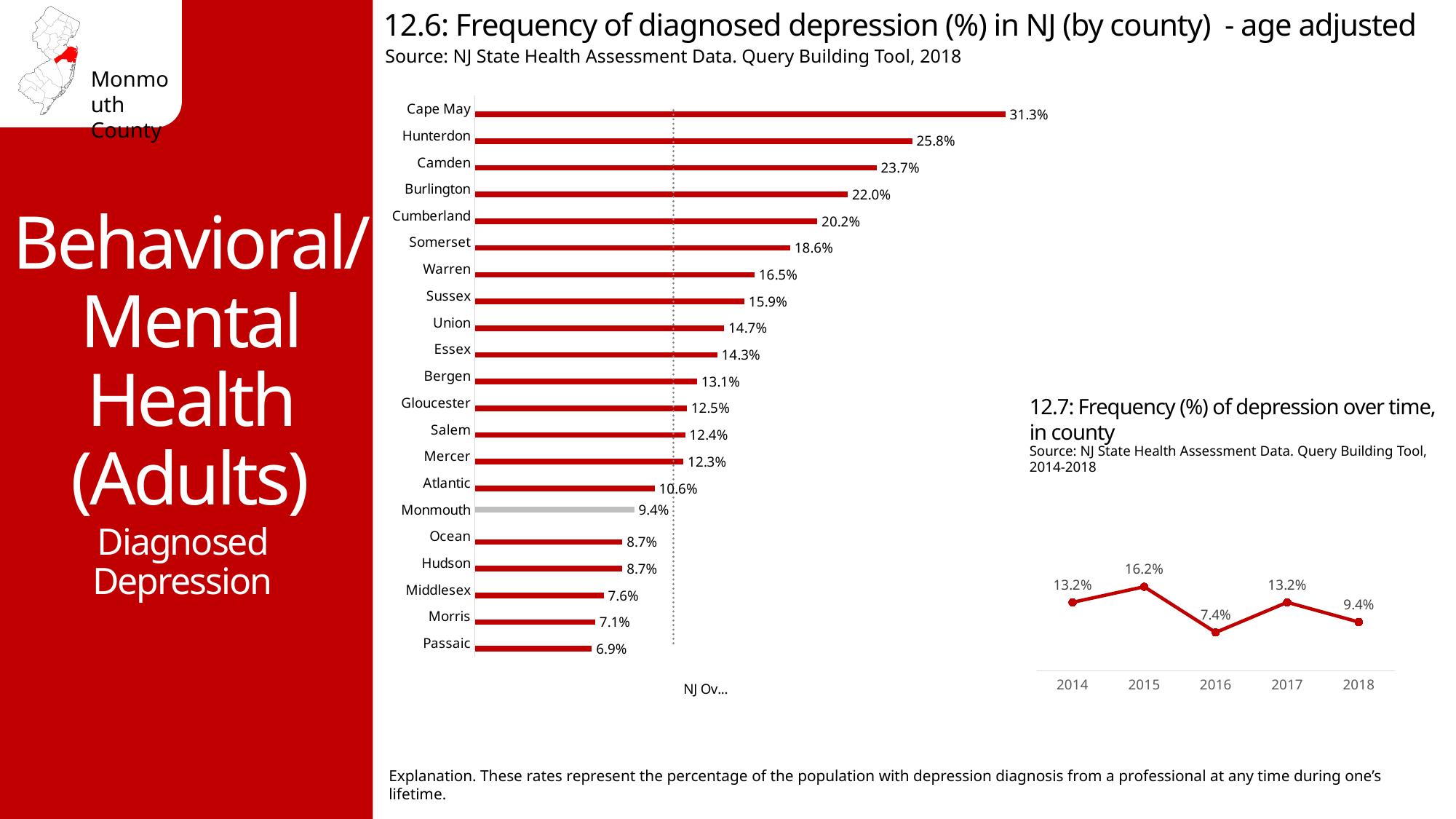
What type of chart is chart 12.6? Bar chart In chart 12.6, what is the difference between the values for Hunterdon and Camden? 2.1% In chart 12.6, which county has the highest frequency of diagnosed depression? Cape May In chart 12.6, what is the value shown for Monmouth? 9.4% How many counties are shown in chart 12.6? 21 In chart 12.6, which county has a higher value, Bergen or Gloucester? Bergen In chart 12.6, which county has the lowest frequency of diagnosed depression? Passaic In chart 12.7, which year has the lowest frequency of depression? 2016 In chart 12.6, what is the frequency of diagnosed depression for Cape May? 31.3% In chart 12.7, what is the frequency of depression in 2015? 16.2% In chart 12.7, what is the difference between the 2017 and 2018 values? 3.8% How many years are plotted in chart 12.7? 5